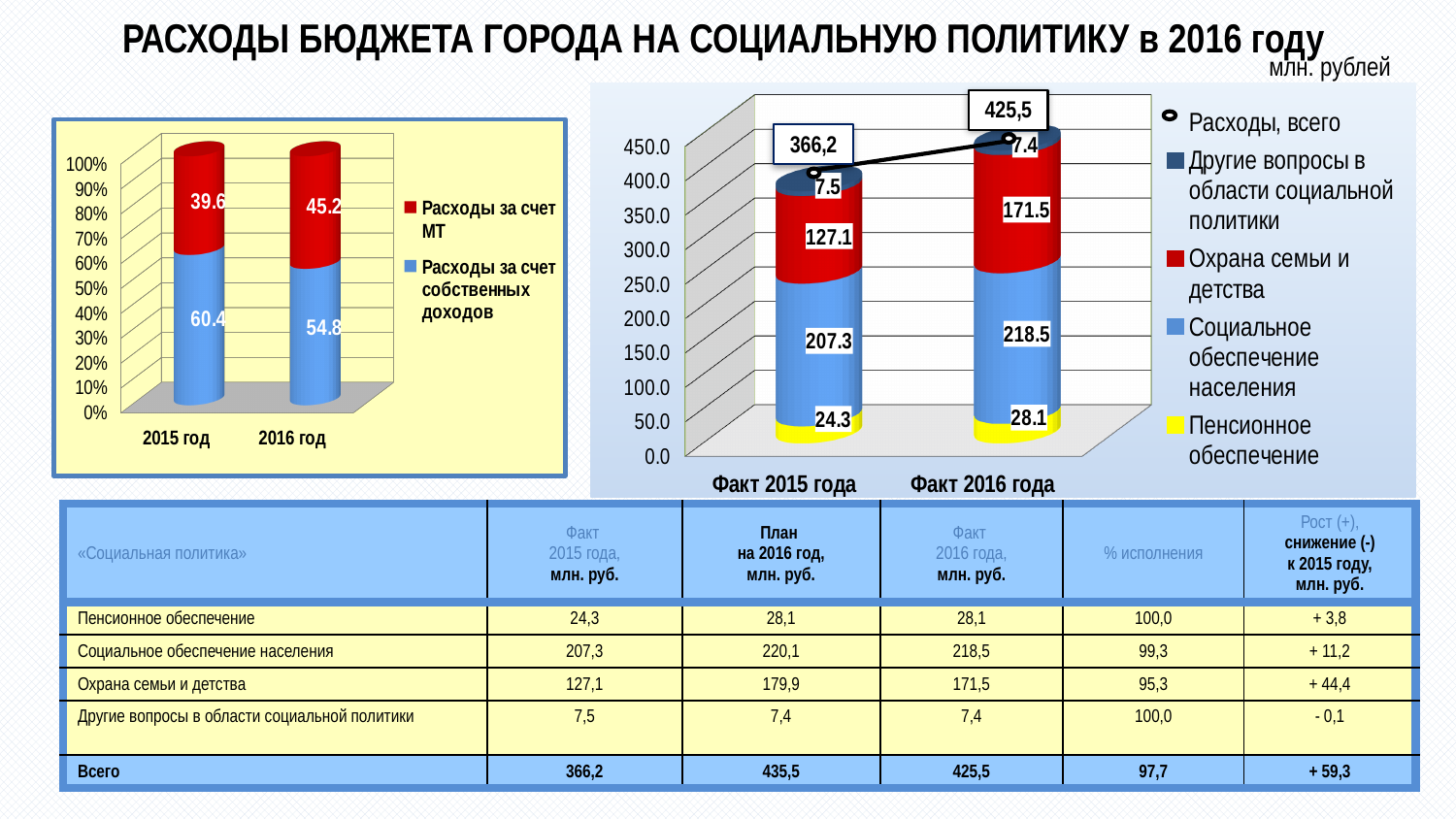
In the left chart, which year has the larger share of «Расходы за счет МТ», 2015 год or 2016 год? 2016 год What kind of chart is the right chart? stacked bar chart with a line In the right chart, what is the value of «Охрана семьи и детства» for Факт 2015 года? 127.1 In the left chart, what is the value of «Расходы за счет МТ» for 2015 год? 39.6 In the right chart, does «Расходы, всего» rise or fall from Факт 2015 года to Факт 2016 года? rise In the right chart, what is the difference in «Пенсионное обеспечение» between Факт 2016 года and Факт 2015 года? 3.8 In the left chart, what is the value of «Расходы за счет собственных доходов» for 2016 год? 54.8 In the right chart, which segment is the smallest for Факт 2015 года? Другие вопросы в области социальной политики In the right chart, how many entries does the legend list? 5 In the right chart, what is the value of «Социальное обеспечение населения» for Факт 2016 года? 218.5 In the left chart, how many series does the legend list? 2 In the right chart, what is the total «Расходы, всего» for Факт 2016 года? 425,5